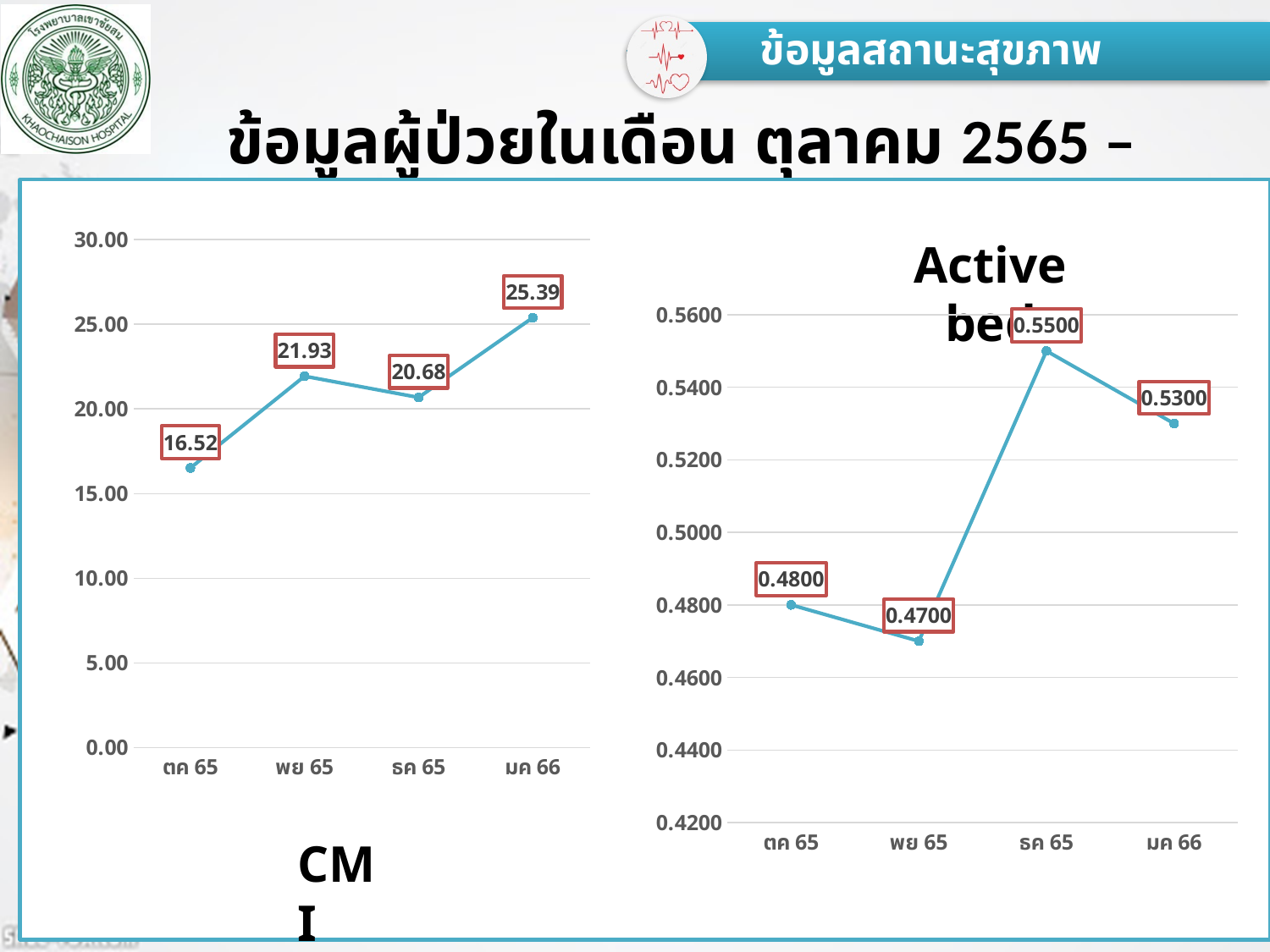
What type of chart is the left chart (CMI)? Line chart In the right chart (Active bed), what is the value for มค 66? 0.5300 In the right chart (Active bed), which month has the highest value? ธค 65 How many data points are plotted in the right chart (Active bed)? 4 In the left chart (CMI), which month has the highest value? มค 66 In the right chart (Active bed), what is the value for พย 65? 0.4700 In the left chart (CMI), what is the value for ตค 65? 16.52 In the left chart (CMI), what is the value for ธค 65? 20.68 In the left chart (CMI), which is larger, the value for พย 65 or ธค 65? พย 65 In the left chart (CMI), which month has the lowest value? ตค 65 In the left chart (CMI), what is the difference between the values for มค 66 and ตค 65? 8.87 In the right chart (Active bed), what is the difference between the values for ธค 65 and พย 65? 0.0800